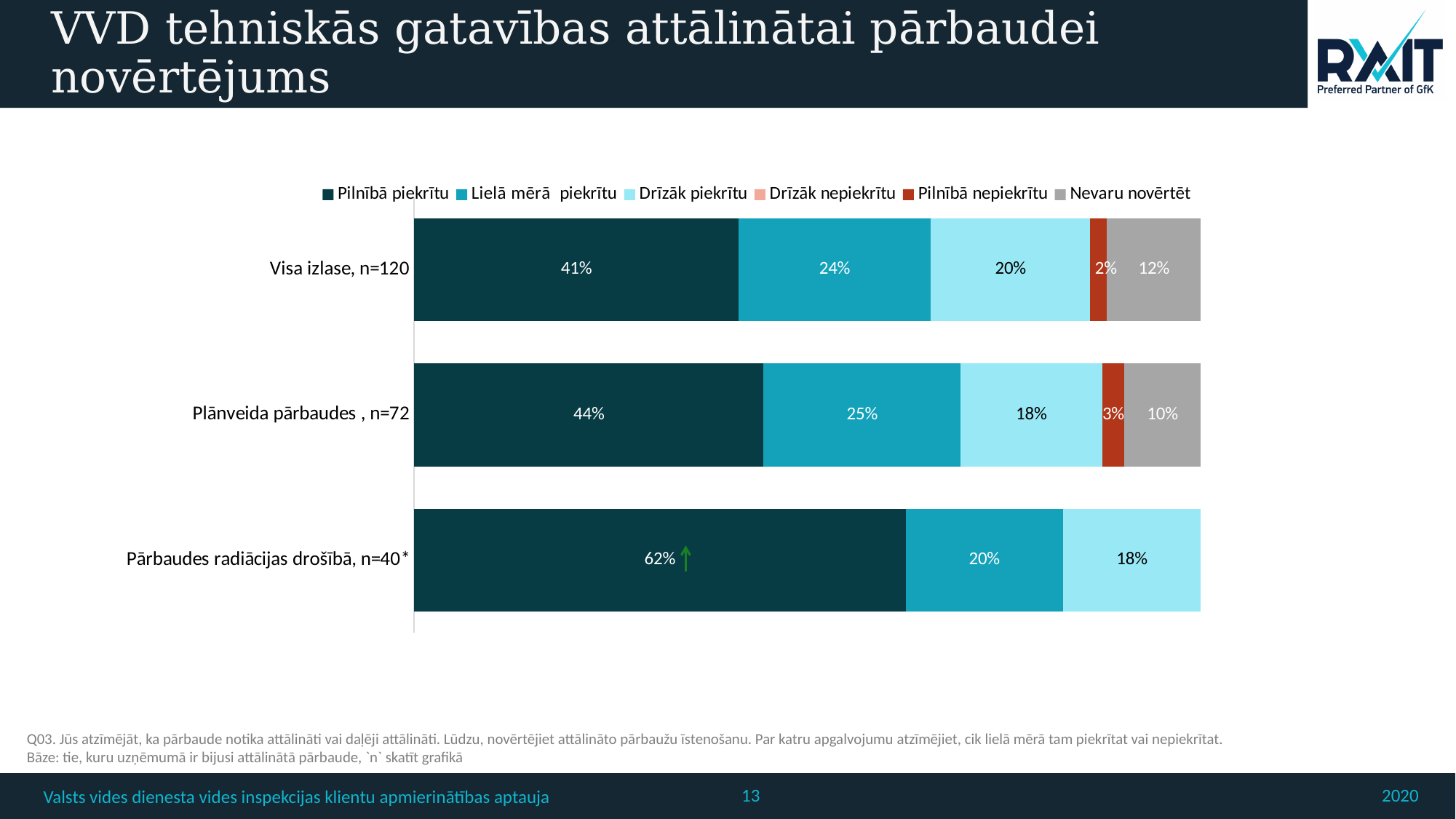
What percentage of respondents in the 'Visa izlase, n=120' group answered 'Pilnībā piekrītu'? 41% How many series does the legend list? 6 What is the 'Lielā mērā piekrītu' value for 'Plānveida pārbaudes , n=72'? 25% How many groups (bars) are shown in the chart? 3 What type of chart is shown on the slide? Stacked bar chart By how many percentage points does the 'Pilnībā piekrītu' share for 'Pārbaudes radiācijas drošībā, n=40*' exceed that of 'Visa izlase, n=120'? 21 percentage points Which group has the larger 'Drīzāk piekrītu' share: 'Visa izlase, n=120' or 'Plānveida pārbaudes , n=72'? Visa izlase, n=120 Which group has the lowest 'Pilnībā piekrītu' share? Visa izlase, n=120 What is the 'Pilnībā piekrītu' value for 'Pārbaudes radiācijas drošībā, n=40*'? 62% What is the 'Nevaru novērtēt' value for 'Plānveida pārbaudes , n=72'? 10% What share of 'Visa izlase, n=120' answered 'Nevaru novērtēt'? 12% Which group has the highest 'Pilnībā piekrītu' share? Pārbaudes radiācijas drošībā, n=40*